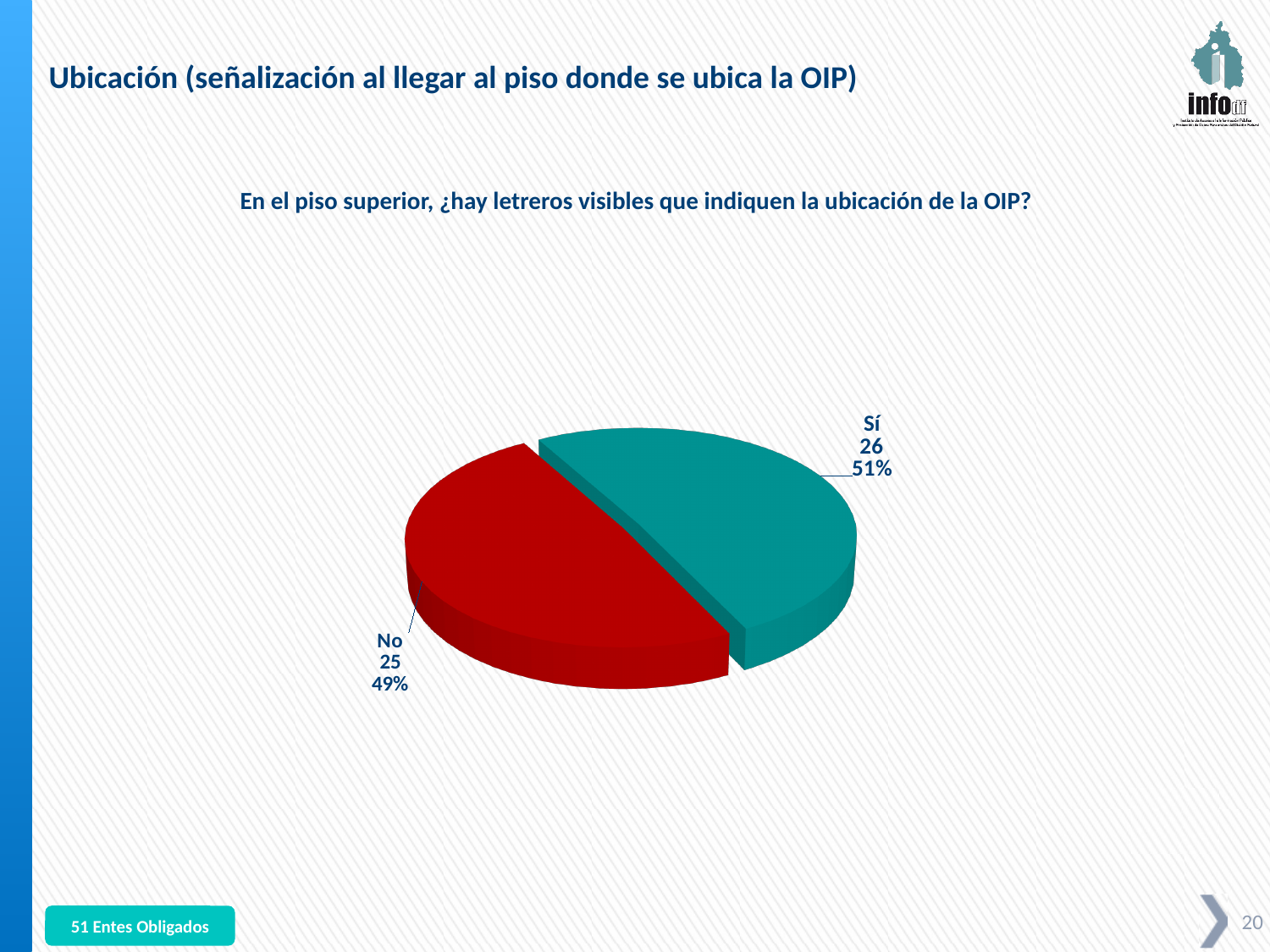
Which slice is the largest? Sí What percentage share does the "Sí" slice represent? 51% How many slices does the pie chart have? 2 What is the total of the two slice counts? 51 What question does the pie chart answer, according to the text above it? En el piso superior, ¿hay letreros visibles que indiquen la ubicación de la OIP? What is the count for the "Sí" slice? 26 What is the count for the "No" slice? 25 Which slice is the smallest? No What is the difference between the counts for "Sí" and "No"? 1 What colour is the "No" slice? red What kind of chart is shown on the slide? pie chart What percentage share does the "No" slice represent? 49%